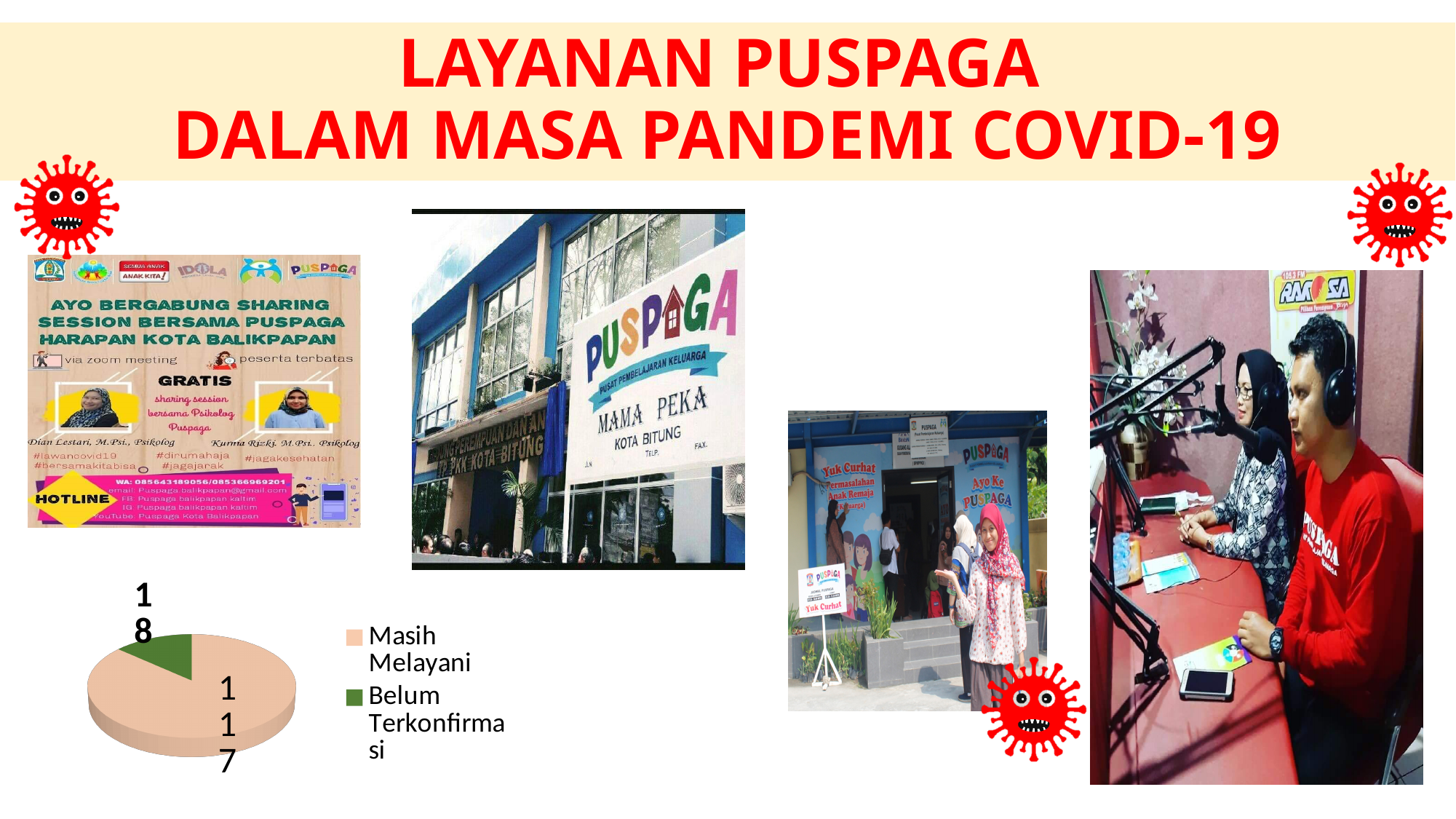
In the pie chart, what is the value for Masih Melayani? 117 How many slices does the pie chart have? 2 What type of chart is shown at the bottom left of the slide? Pie chart In the pie chart, which is larger: Masih Melayani or Belum Terkonfirmasi? Masih Melayani What is the total of the two values shown in the pie chart? 135 What colour is the Masih Melayani slice in the pie chart? Peach (light orange) What colour is the Belum Terkonfirmasi slice in the pie chart? Green Which slice of the pie chart is the largest? Masih Melayani How many entries does the legend of the pie chart list? 2 In the pie chart, what is the value for Belum Terkonfirmasi? 18 Which slice of the pie chart is the smallest? Belum Terkonfirmasi In the pie chart, what is the difference between the values for Masih Melayani and Belum Terkonfirmasi? 99